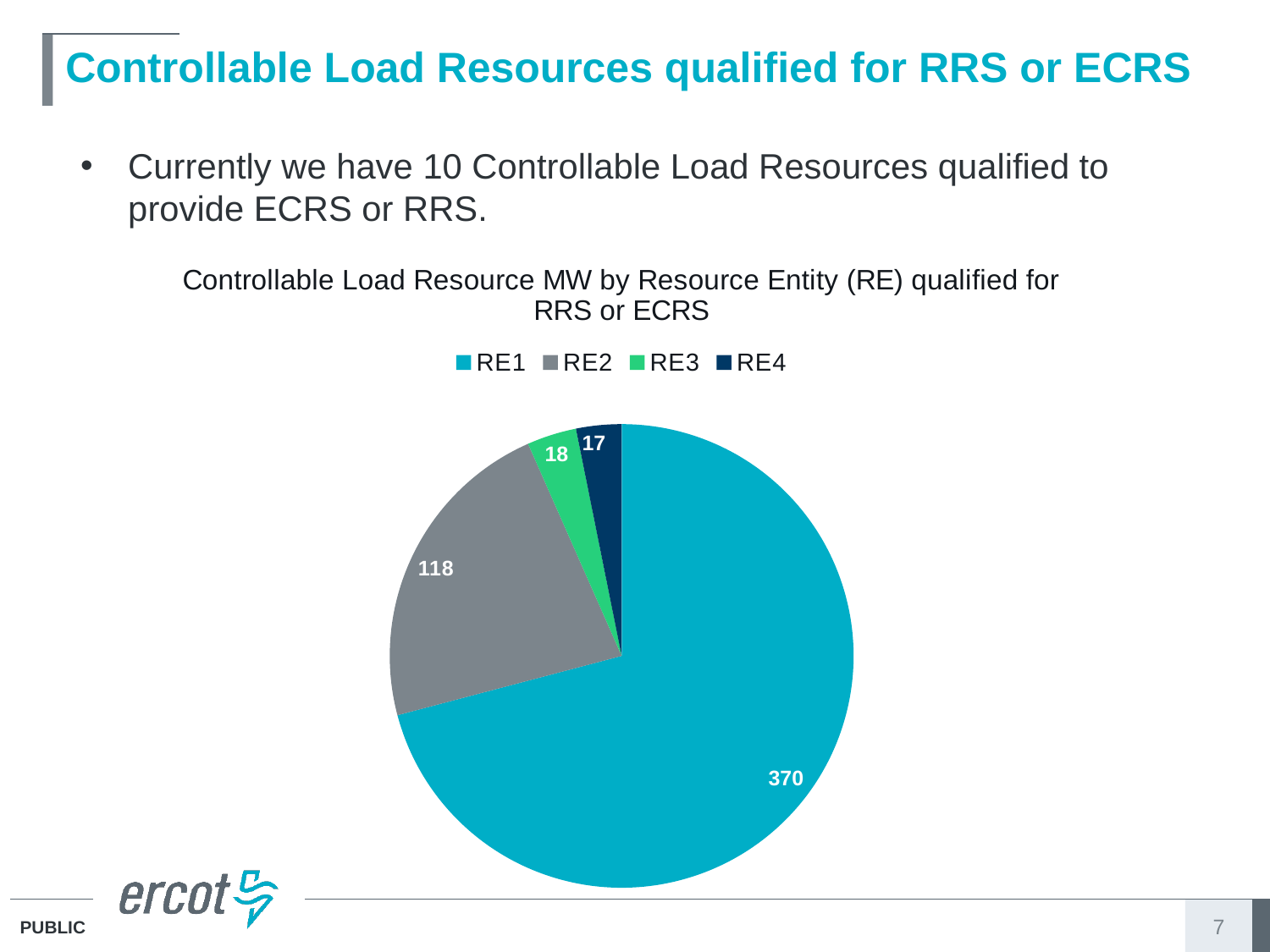
Which is larger, the value for RE2 or the value for RE3? RE2 Which Resource Entity has the largest slice of the pie chart? RE1 Which Resource Entity has the smallest slice of the pie chart? RE4 What is the MW value for RE3 in the pie chart? 18 What type of chart is shown on the slide? pie chart What is the MW value for RE4 in the pie chart? 17 What is the MW value for RE1 in the pie chart? 370 What is the difference between the values for RE1 and RE2? 252 What is the total of all slices in the pie chart? 523 What is the MW value for RE2 in the pie chart? 118 How many Resource Entities are shown in the pie chart? 4 What is the title of the pie chart? Controllable Load Resource MW by Resource Entity (RE) qualified for RRS or ECRS